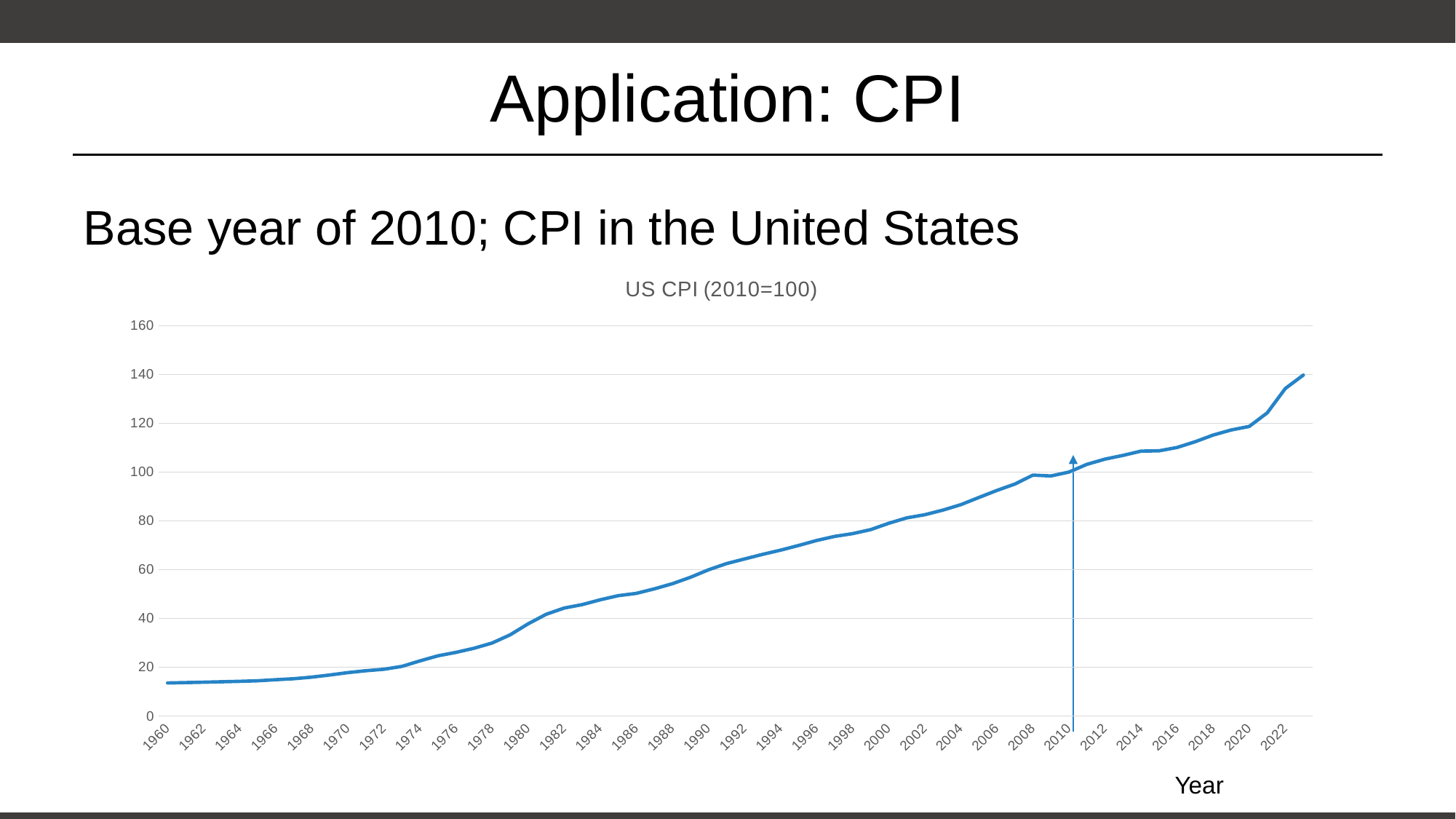
Is the value for 1960 greater or less than 20? less What is the label of the x axis? Year Do the CPI values generally rise or fall from 1960 to 2022? rise Is the value for 2016 greater or less than 100? greater What is the title of the chart? US CPI (2010=100) Is the value for 1976 greater or less than 20? greater Which year has the lowest CPI value on the chart? 1960 What type of chart is shown on the slide? line chart Which is larger, the CPI value for 1990 or for 2010? 2010 What is the CPI value for the base year 2010? 100